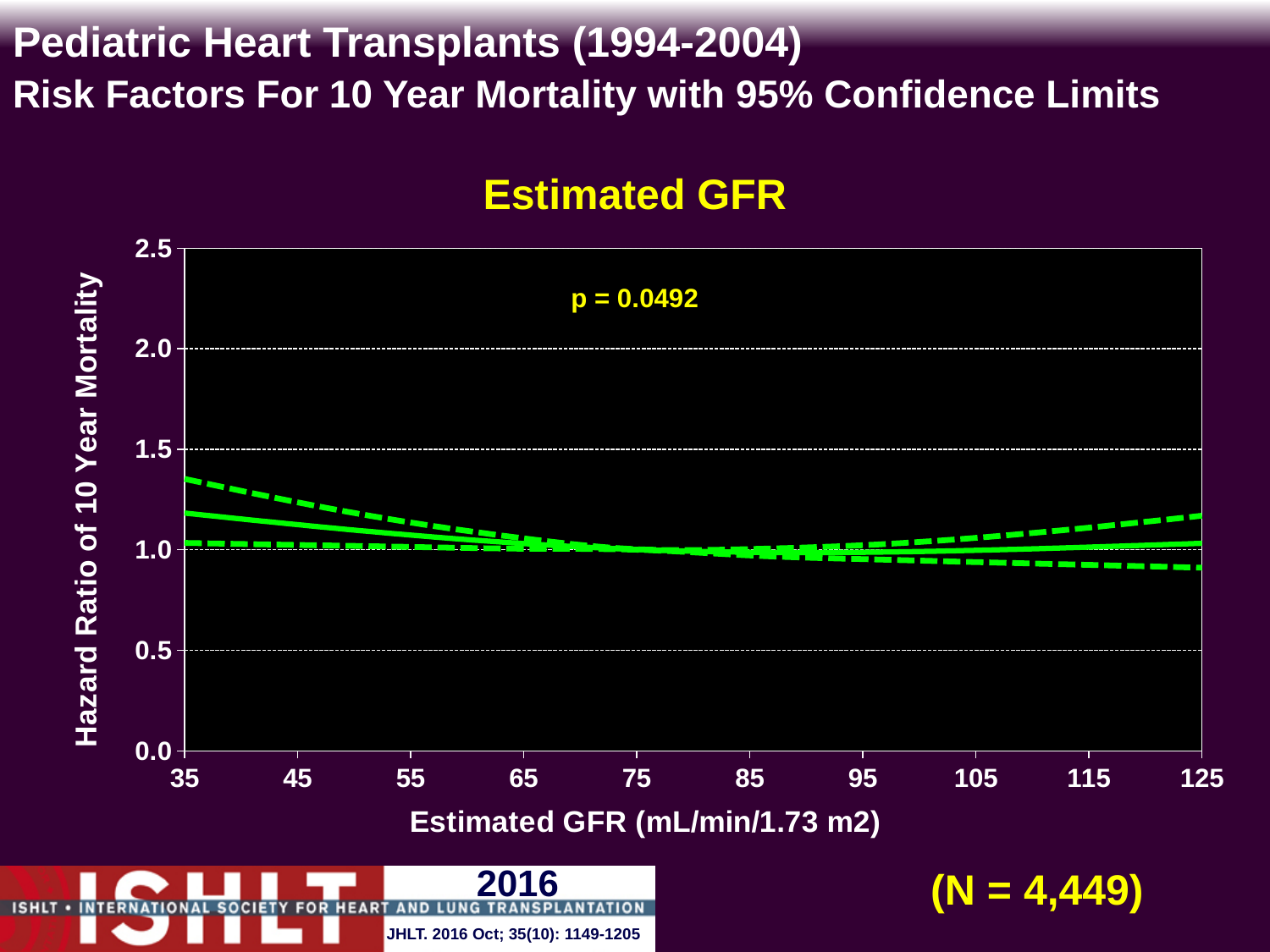
Is the hazard ratio (solid line) at an estimated GFR of 125 greater or less than 1.5? less What is the title of the chart? Estimated GFR Is the lower confidence limit (lower dashed line) at an estimated GFR of 125 greater or less than 1.0? less How many lines are plotted on the chart? 3 What kind of chart is shown on the slide? line chart Does the solid hazard ratio line rise or fall as estimated GFR increases from 35 to 75? fall Is the upper confidence limit (upper dashed line) at an estimated GFR of 35 greater or less than 1.5? less What p-value is printed on the chart? p = 0.0492 Which is larger, the hazard ratio (solid line) at an estimated GFR of 35 or at 125? 35 What is the highest value shown on the y axis? 2.5 How many tick labels are shown on the x axis? 10